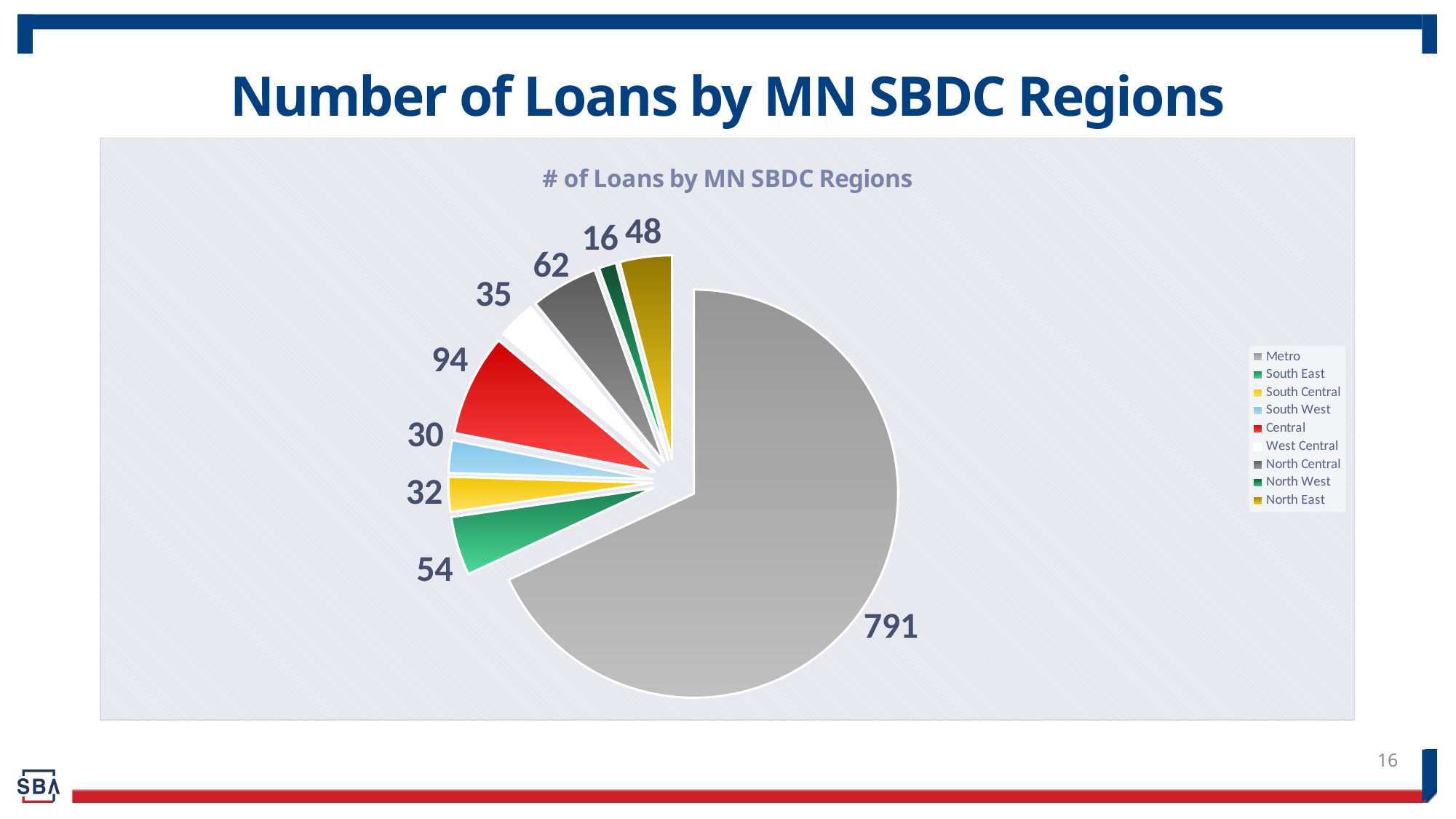
What is the total number of loans across all regions? 1162 What is the difference in loans between the Central and North Central regions? 32 Which region has the lowest number of loans? North West Which region has more loans, North East or West Central? North East Which region has the highest number of loans? Metro How many loans does the South East region have? 54 How many regions are shown in the pie chart? 9 How many loans does the North West region have? 16 How many loans does the Central region have? 94 How many loans does the Metro region have? 791 What is the title of the chart? # of Loans by MN SBDC Regions What type of chart is shown on the slide? pie chart